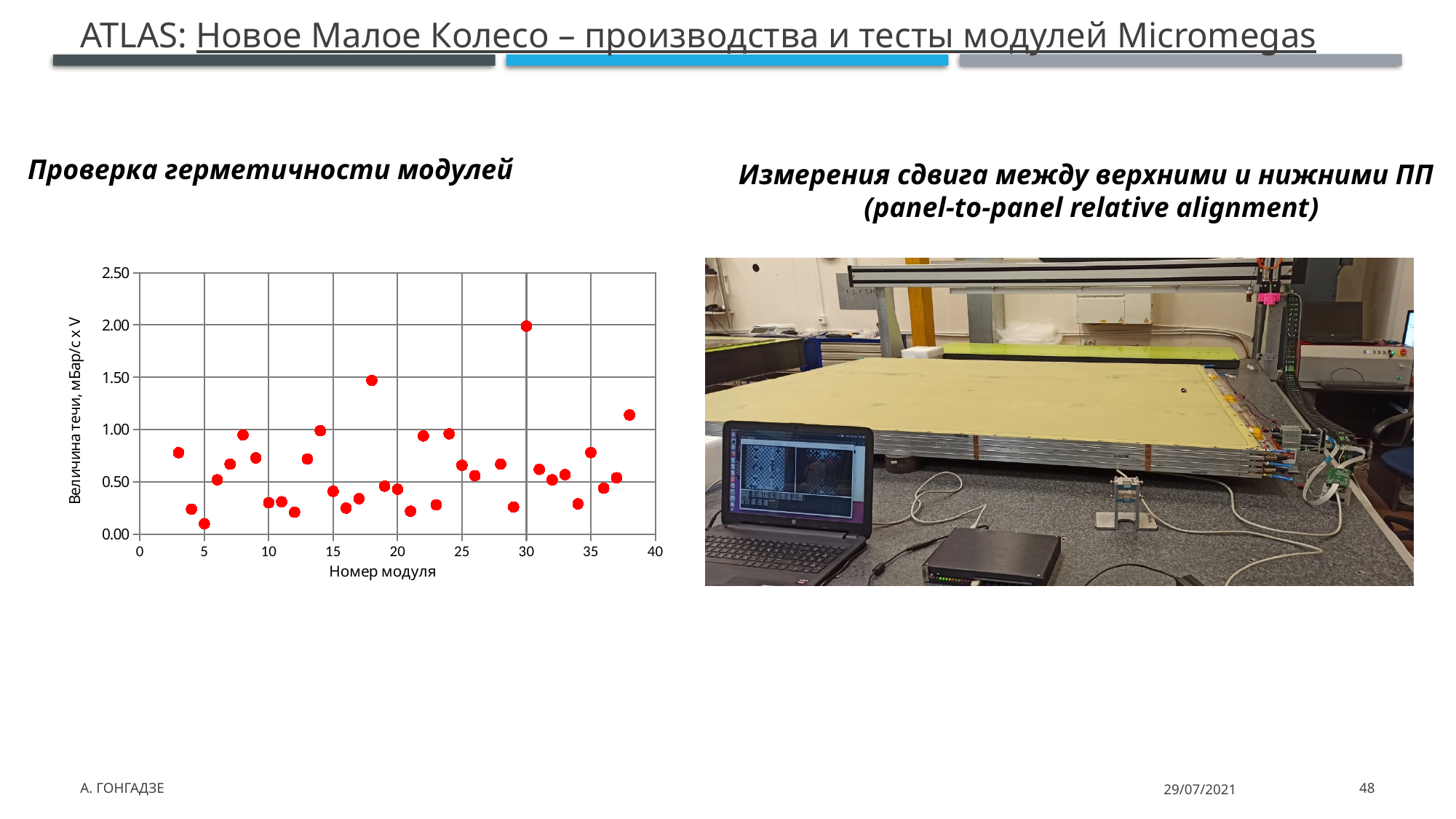
What is the title of the y axis of the chart? Величина течи, мБар/с x V Is the leak value for module 5 greater or less than 0.50? less What is the title of the x axis of the chart? Номер модуля What kind of chart is shown on the slide? scatter chart Which has the larger leak value, module 30 or module 18? module 30 Which has the larger leak value, module 3 or module 5? module 3 Is the leak value for module 3 greater or less than 0.50? greater Which module number has the lowest leak value in the chart? 5 Is the leak value for module 18 greater or less than 1.00? greater Which module number has the highest leak value in the chart? 30